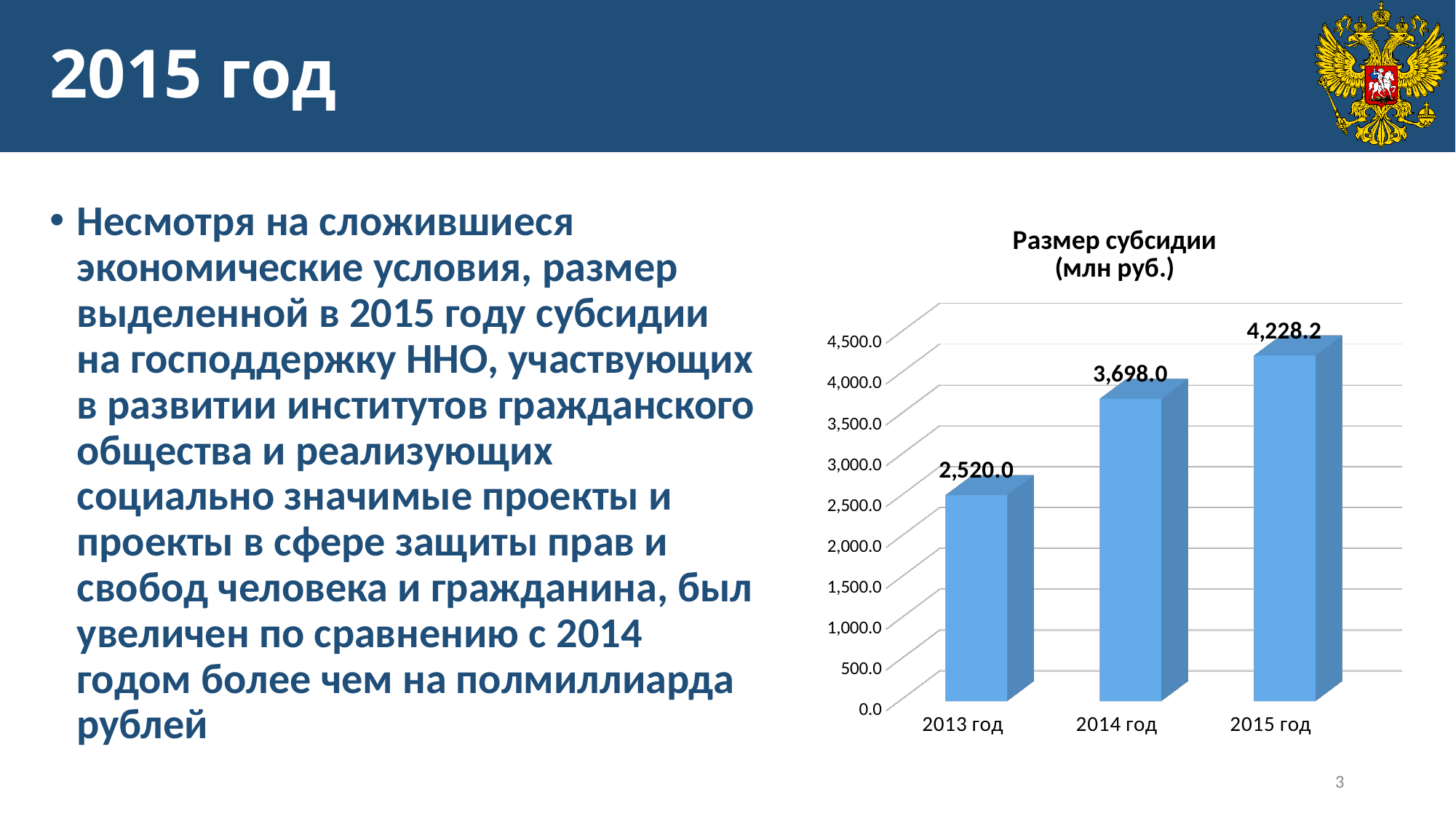
What is the difference between the values for 2014 год and 2013 год? 1,178.0 How many years (categories) are shown in the chart? 3 What is the value for 2015 год in the chart? 4,228.2 What kind of chart is shown on the slide? bar chart Which year has the lowest subsidy value in the chart? 2013 год What is the difference between the values for 2015 год and 2014 год? 530.2 What is the value for 2013 год in the chart? 2,520.0 Is the value for 2015 год greater or less than 4,000.0? greater Which is larger, the value for 2014 год or the value for 2013 год? 2014 год Do the values rise or fall from 2013 год to 2015 год? rise Which year has the highest subsidy value in the chart? 2015 год What is the value for 2014 год in the chart? 3,698.0